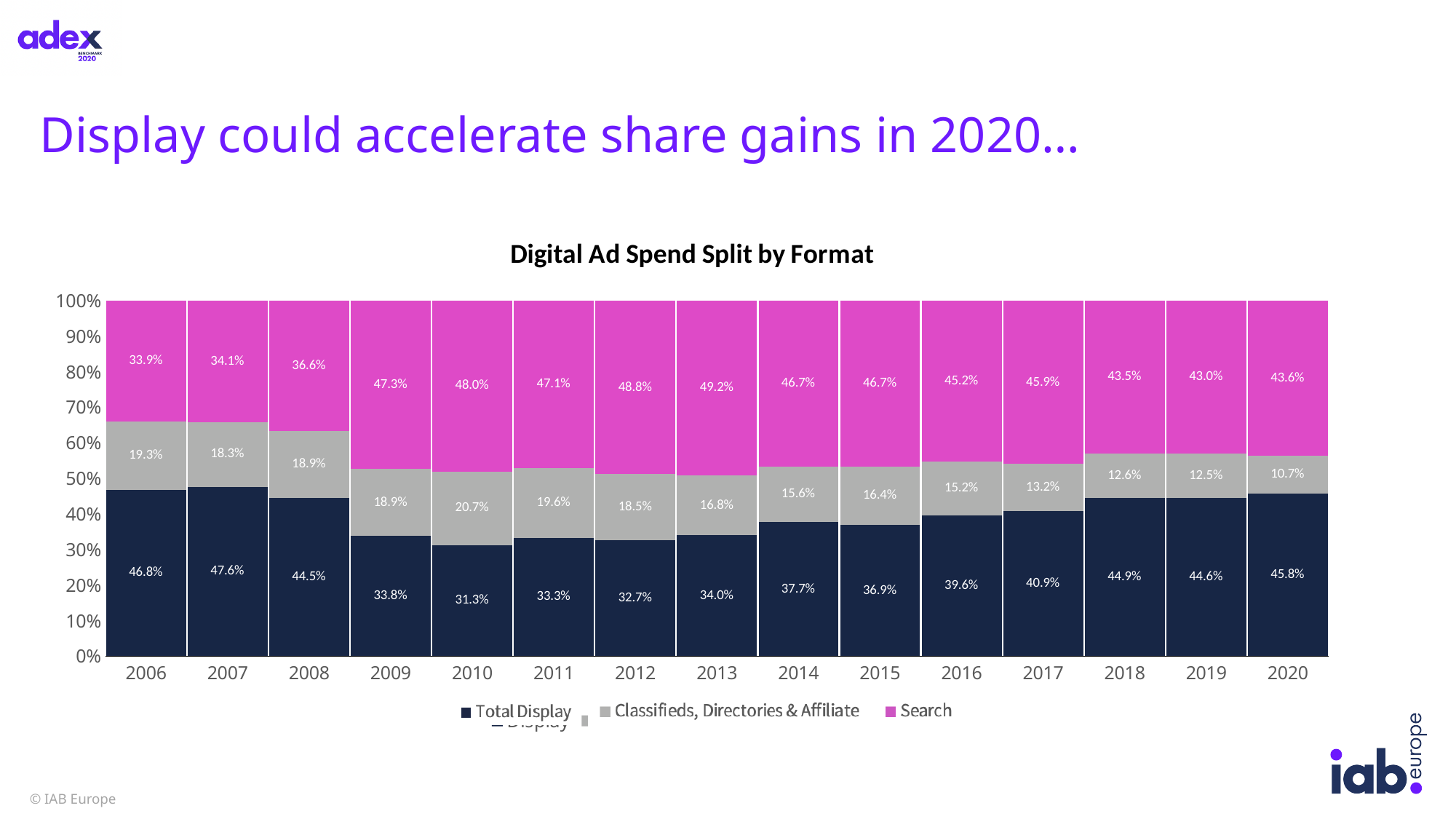
Which year has the larger Total Display share, 2007 or 2020? 2007 What is the Total Display share in 2020? 45.8% In which year is the Search share highest? 2013 What kind of chart is shown on the slide? Stacked bar chart How many years are shown on the x axis? 15 What is the Classifieds, Directories & Affiliate share in 2010? 20.7% By how many percentage points did the Total Display share change from 2010 to 2020? 14.5 percentage points How many series does the legend list? 3 Does the Classifieds, Directories & Affiliate share rise or fall from 2016 to 2020? Fall In which year is the Total Display share lowest? 2010 In which year is the Classifieds, Directories & Affiliate share lowest? 2020 What is the Search share in 2013? 49.2%